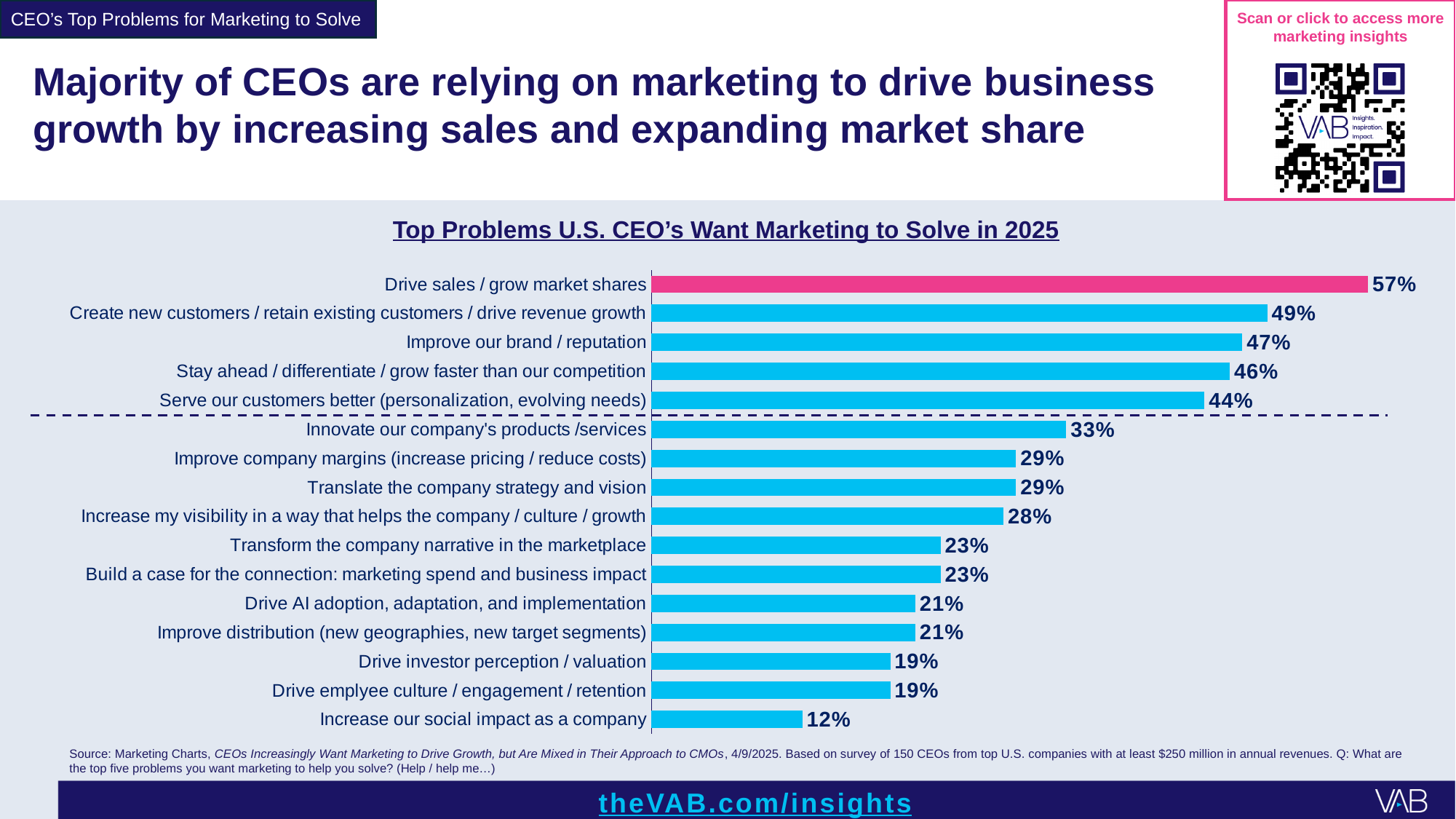
What is the title of the chart? Top Problems U.S. CEO's Want Marketing to Solve in 2025 Which is larger: 'Stay ahead / differentiate / grow faster than our competition' or 'Transform the company narrative in the marketplace'? Stay ahead / differentiate / grow faster than our competition How many problems (categories) are shown in the chart? 16 Which problem has the highest percentage in the chart? Drive sales / grow market shares Which bar is highlighted in a different colour (pink) from the others? Drive sales / grow market shares What is the value for 'Drive AI adoption, adaptation, and implementation'? 21% What is the difference between 'Serve our customers better (personalization, evolving needs)' and 'Innovate our company's products /services'? 11% What percentage of CEOs want marketing to drive sales / grow market shares? 57% What is the value for 'Improve our brand / reputation'? 47% Which problem has the lowest percentage in the chart? Increase our social impact as a company What is the difference between 'Drive sales / grow market shares' and 'Create new customers / retain existing customers / drive revenue growth'? 8% What type of chart is shown on the slide? Bar chart